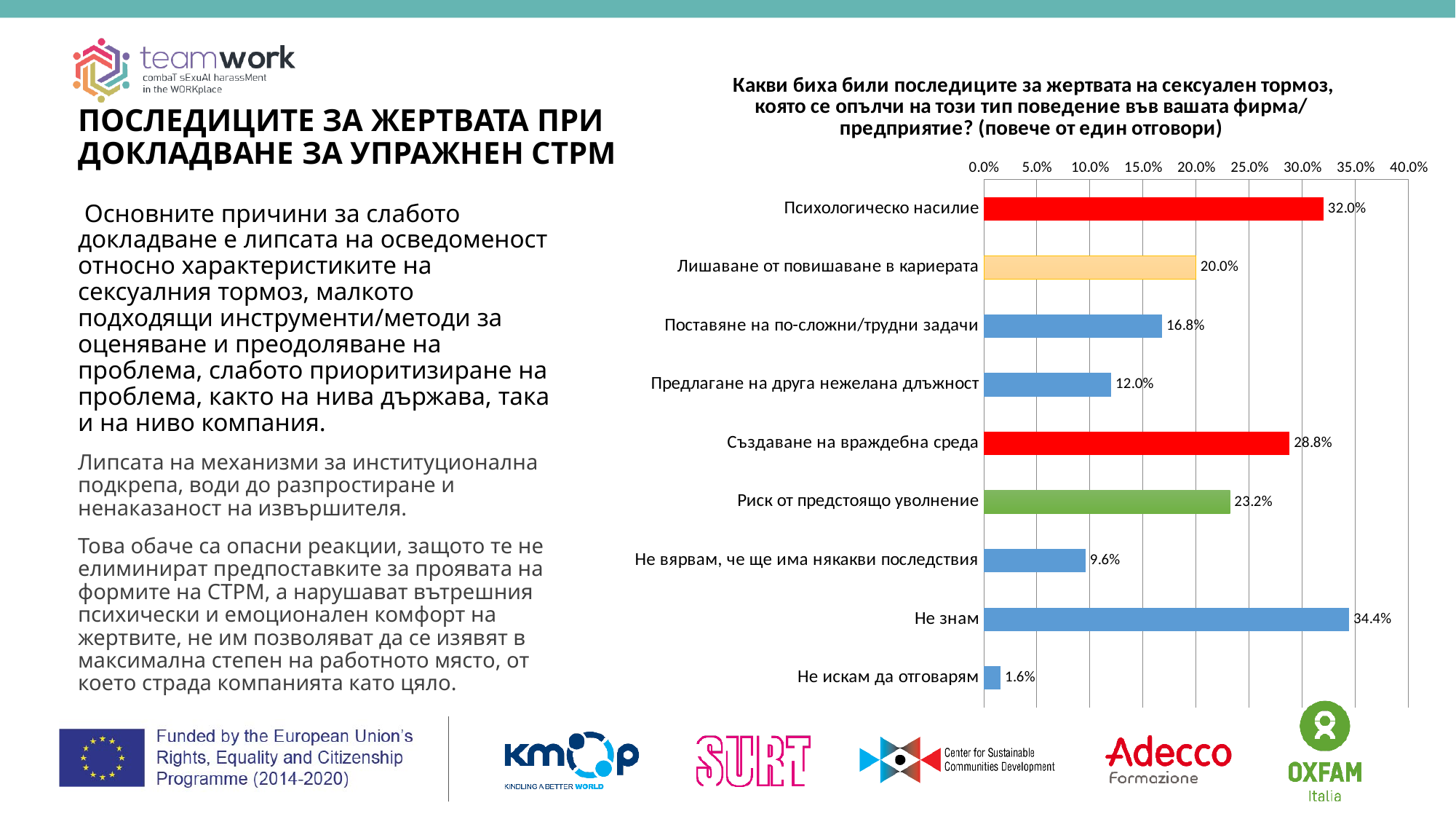
What colour are the bars for "Психологическо насилие" and "Създаване на враждебна среда"? Red What value is shown for "Риск от предстоящо уволнение"? 23.2% What value is shown for "Психологическо насилие"? 32.0% Which category has the lowest value? Не искам да отговарям Which category has the highest value? Не знам How many categories are shown in the chart? 9 Is the value for "Създаване на враждебна среда" greater or less than 25.0%? greater What kind of chart is shown on the slide? Bar chart Which is larger: the value for "Лишаване от повишаване в кариерата" or the value for "Поставяне на по-сложни/трудни задачи"? Лишаване от повишаване в кариерата What is the difference between the values for "Не знам" and "Не искам да отговарям"? 32.8 percentage points What is the difference between the values for "Психологическо насилие" and "Създаване на враждебна среда"? 3.2 percentage points What value is shown for "Не вярвам, че ще има някакви последствия"? 9.6%